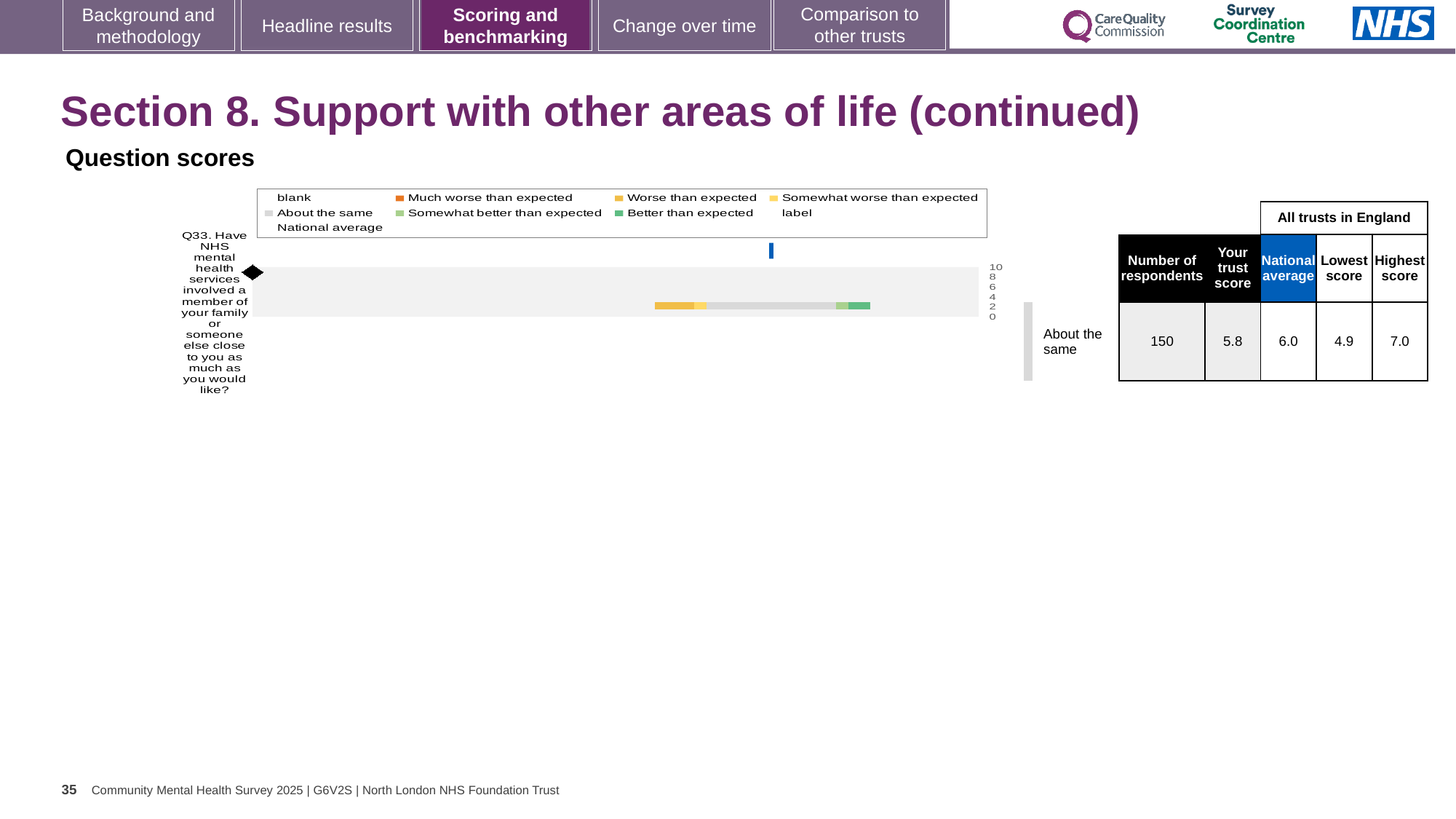
What is the difference between the highest and lowest trust scores for Q33? 2.1 What kind of chart is used to show the Q33 question score? bar chart What is the national average score for Q33? 6.0 Which benchmark category is Q33 assigned to? About the same How many survey questions are plotted on the chart? 1 How many respondents answered Q33? 150 Which is larger for Q33: the trust score or the national average? national average How many entries does the chart legend list? 9 What is the 'Your trust score' value for Q33? 5.8 What is the highest score among all trusts in England for Q33? 7.0 What is the lowest score among all trusts in England for Q33? 4.9 Is the national average for Q33 greater or less than 4? greater